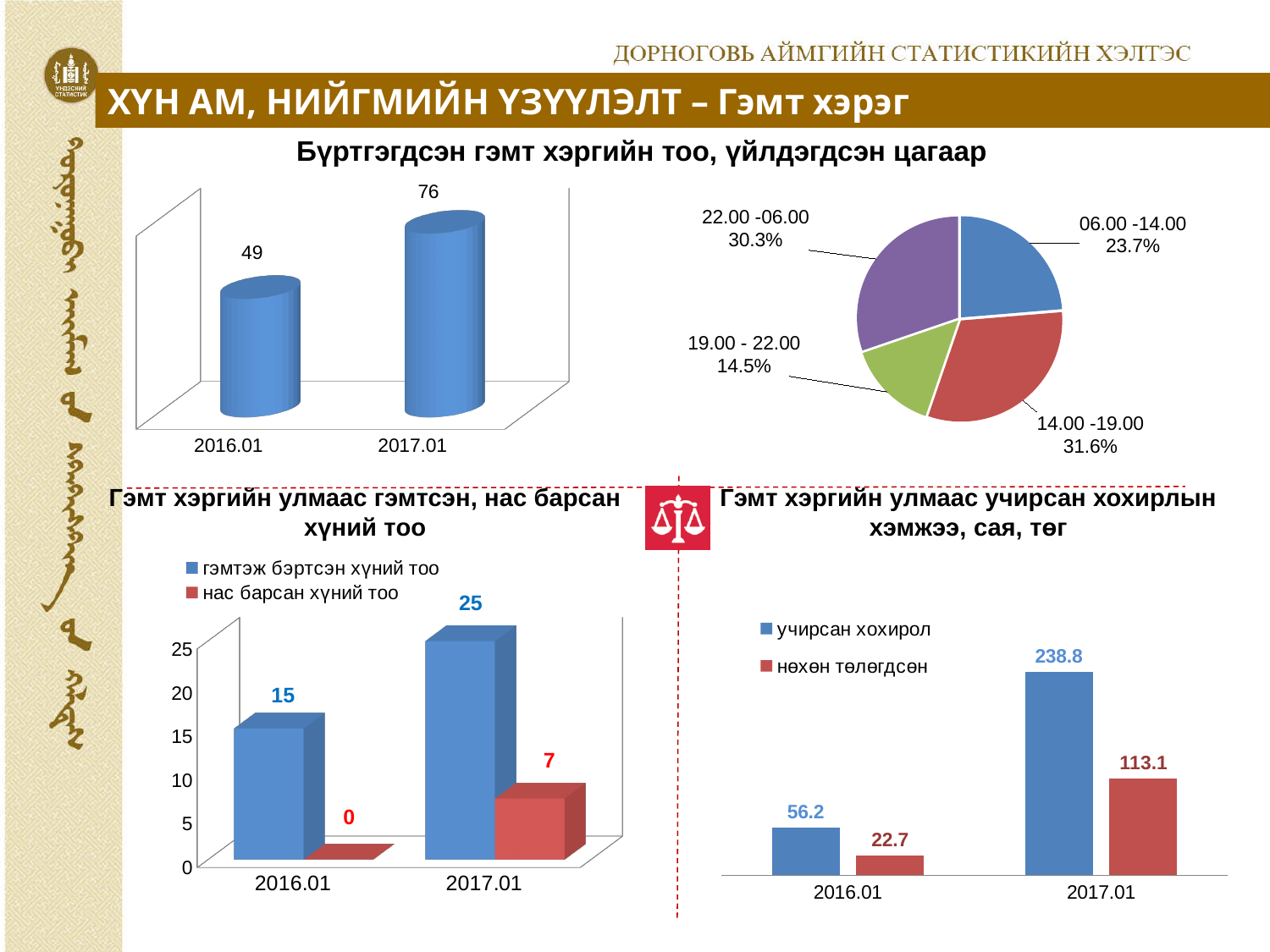
In the top-right pie chart, what share does the 14.00 -19.00 slice have? 31.6% In the bottom-right chart (Гэмт хэргийн улмаас учирсан хохирлын хэмжээ), what is the difference between учирсан хохирол and нөхөн төлөгдсөн for 2016.01? 33.5 In the bottom-right chart, which is larger for 2017.01: учирсан хохирол or нөхөн төлөгдсөн? учирсан хохирол How many series does the legend of the bottom-left chart list? 2 What type of chart is the top-right chart on the slide? Pie chart In the top-left bar chart (Бүртгэгдсэн гэмт хэргийн тоо), what is the difference between the 2017.01 and 2016.01 values? 27 In the bottom-left chart (Гэмт хэргийн улмаас гэмтсэн, нас барсан хүний тоо), what is the value of гэмтэж бэртсэн хүний тоо for 2016.01? 15 How many slices does the top-right pie chart have? 4 In the bottom-right chart (Гэмт хэргийн улмаас учирсан хохирлын хэмжээ), what is the value of учирсан хохирол for 2017.01? 238.8 In the top-left bar chart (Бүртгэгдсэн гэмт хэргийн тоо), what is the value for 2017.01? 76 In the top-right pie chart, which time period has the smallest share? 19.00 - 22.00 In the bottom-left chart (Гэмт хэргийн улмаас гэмтсэн, нас барсан хүний тоо), what is the value of нас барсан хүний тоо for 2017.01? 7